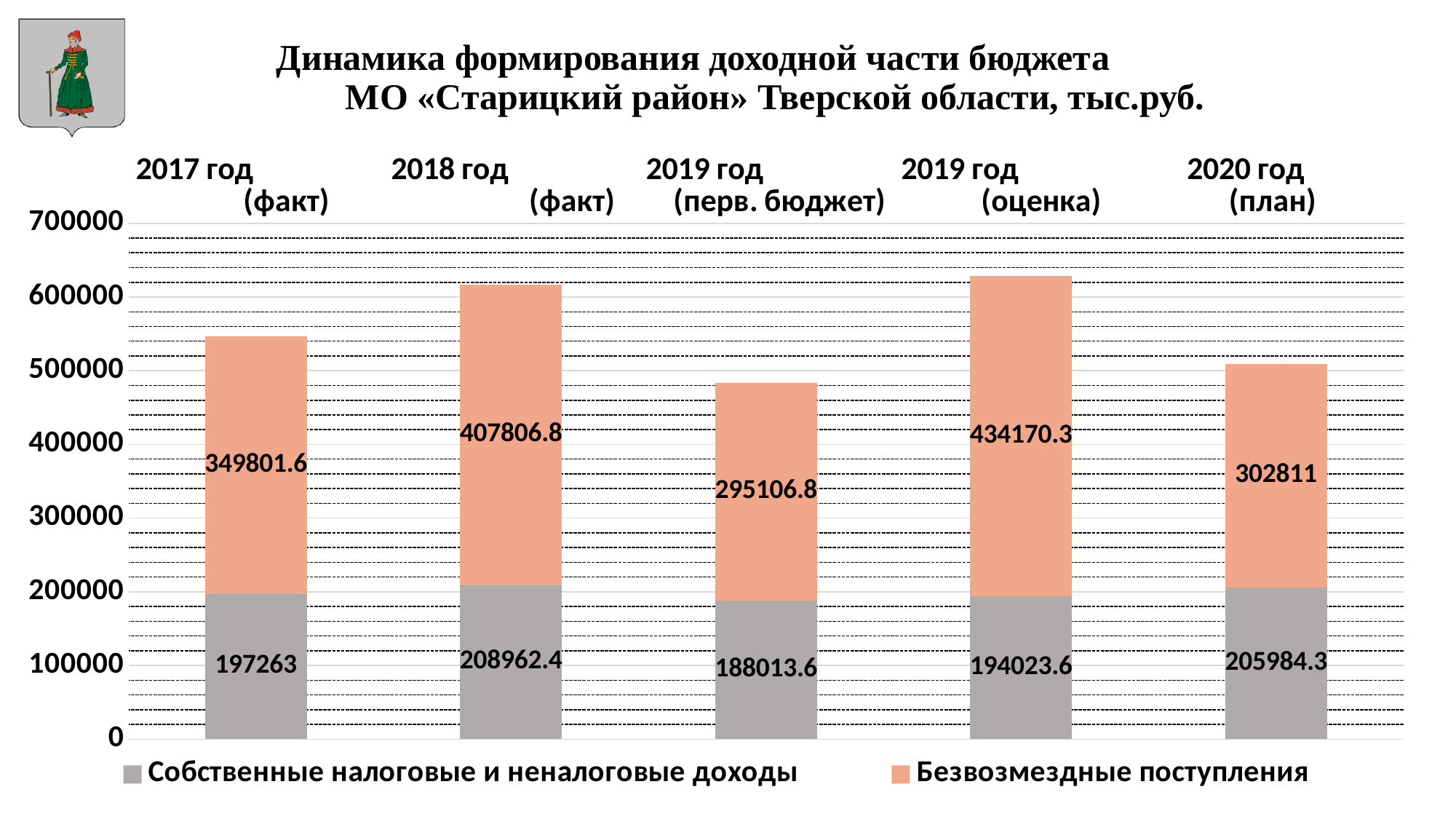
What colour represents «Безвозмездные поступления» in the chart? Orange (salmon) Which is larger: «Собственные налоговые и неналоговые доходы» for 2018 год (факт) or for 2019 год (перв. бюджет)? 2018 год (факт) Which category has the lowest value for «Собственные налоговые и неналоговые доходы»? 2019 год (перв. бюджет) Which category has the highest value for «Безвозмездные поступления»? 2019 год (оценка) How many categories (bars) are shown on the chart? 5 What is the total of the stacked bar for 2017 год (факт)? 547064.6 What is the value of «Безвозмездные поступления» for 2018 год (факт)? 407806.8 What is the value of «Собственные налоговые и неналоговые доходы» for 2020 год (план)? 205984.3 Is the total of the stacked bar for 2019 год (перв. бюджет) greater or less than 500000? less What type of chart is shown on the slide? Stacked bar chart How many series does the legend list? 2 What is the difference between «Безвозмездные поступления» for 2019 год (оценка) and 2017 год (факт)? 84368.7